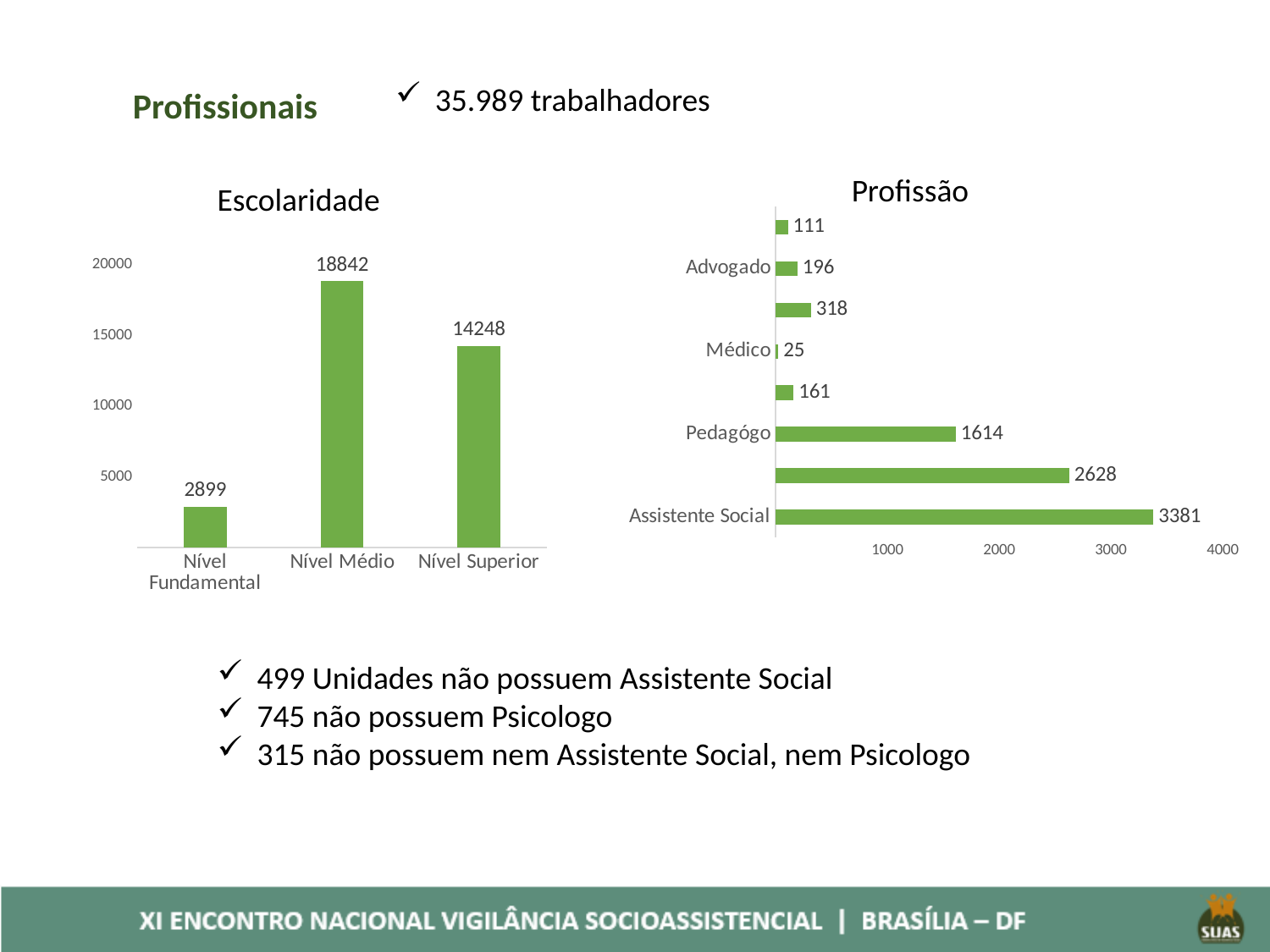
In the Escolaridade chart, what is the difference between Nível Médio and Nível Superior? 4594 What kind of chart is the Profissão chart? bar chart In the Profissão chart, what is the difference between Assistente Social and Pedagógo? 1767 In the Escolaridade chart, what is the value for Nível Médio? 18842 In the Profissão chart, which is larger, Advogado or Pedagógo? Pedagógo In the Profissão chart, what is the value for Pedagógo? 1614 In the Profissão chart, what is the value for Assistente Social? 3381 In the Escolaridade chart, what is the value for Nível Fundamental? 2899 In the Profissão chart, what is the value for Médico? 25 In the Escolaridade chart, which category has the lowest value? Nível Fundamental In the Escolaridade chart, how many categories are shown? 3 In the Escolaridade chart, which category has the highest value? Nível Médio